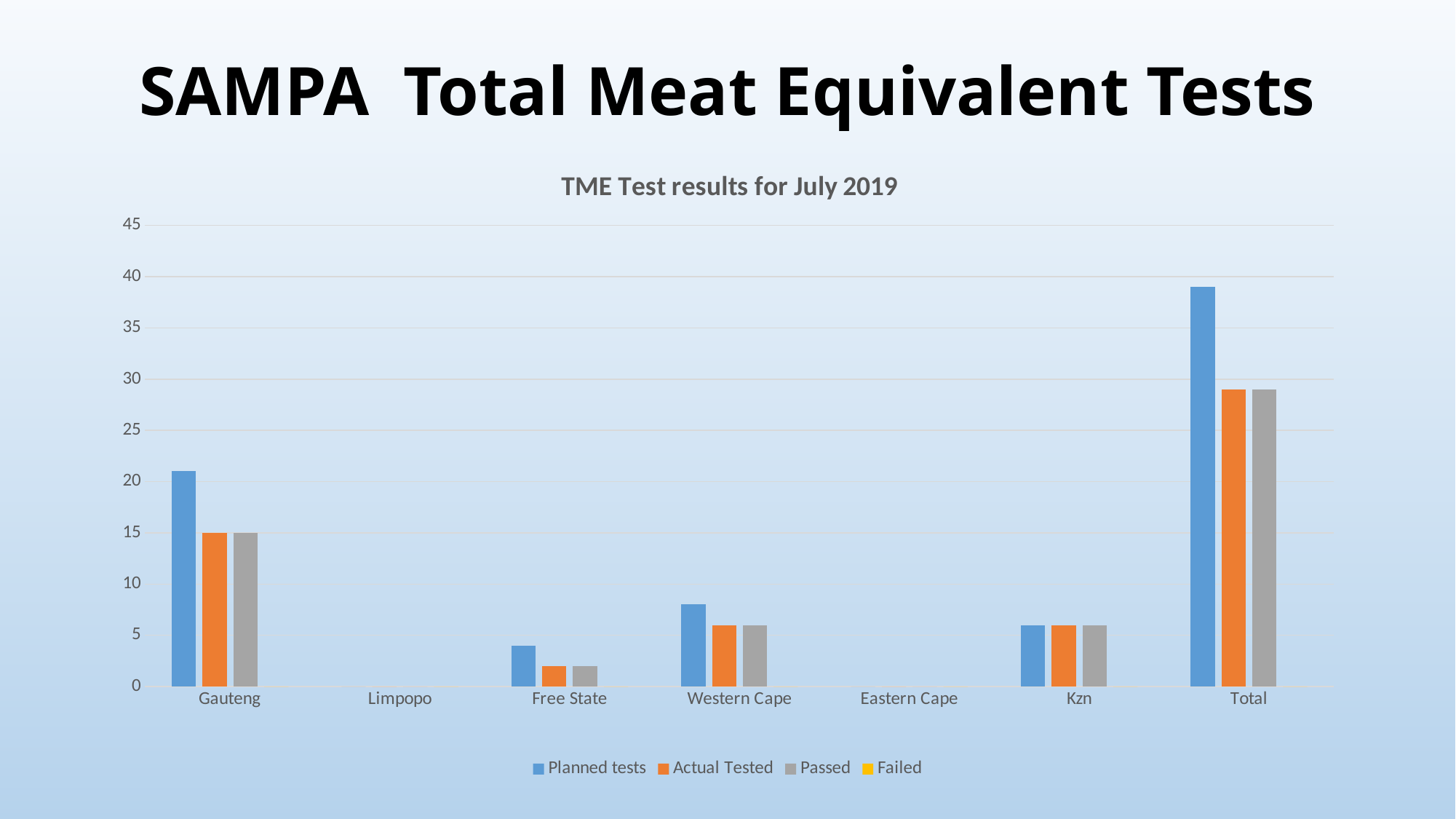
Which series in the legend is shown in orange? Actual Tested How many categories are shown on the x axis? 7 Is the Planned tests value for Western Cape greater or less than 10? less Excluding Total, which province has the highest Planned tests value? Gauteng Is the Planned tests value for Gauteng greater or less than 20? greater What is the Actual Tested value for Gauteng? 15 How many series does the legend list? 4 Which category has the highest Planned tests value? Total Which is larger, the Planned tests value for Western Cape or for Free State? Western Cape What kind of chart is shown on the slide? bar chart Is the Planned tests value for Total greater or less than 35? greater What is the title of the chart? TME Test results for July 2019